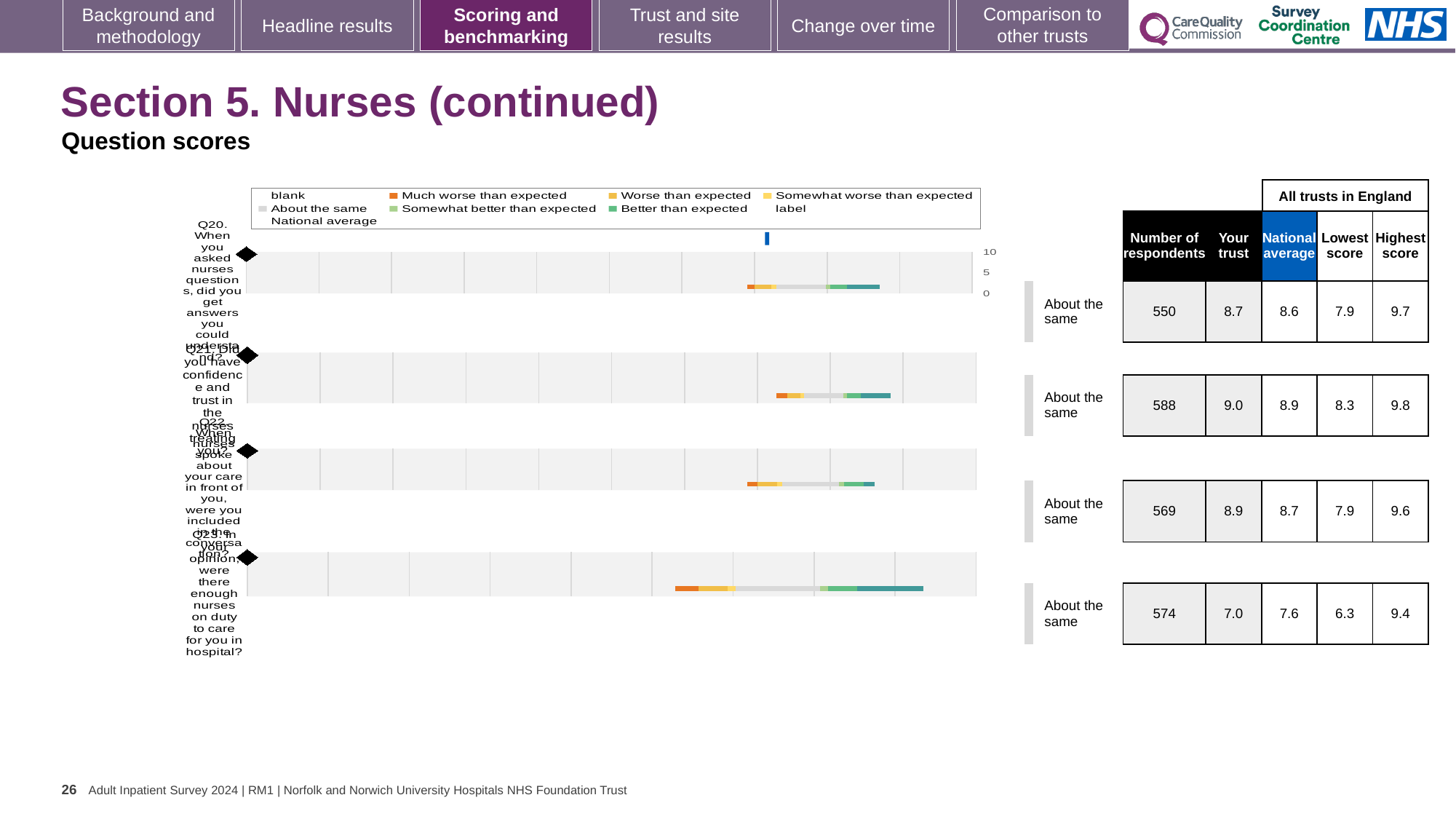
What kind of chart is used to show the question scores for Q20 to Q23? bar chart For Q22, which is larger: the 'Your trust' score or the national average? Your trust What is the difference between the national average and the 'Your trust' score for Q23? 0.6 In the table, how many respondents are listed for Q21? 588 What is the highest value shown on the chart axis? 10 In the table, what is the national average for Q23? 7.6 In the table, what is the 'Your trust' score for Q20? 8.7 How many questions (Q20 to Q23) have a chart on this slide? 4 Which question has the highest 'Your trust' score in the table? Q21 Which question has the lowest 'Your trust' score in the table? Q23 Which legend entry is shown in orange, immediately after 'blank'? Much worse than expected What benchmark category is shown next to the chart for Q23? About the same